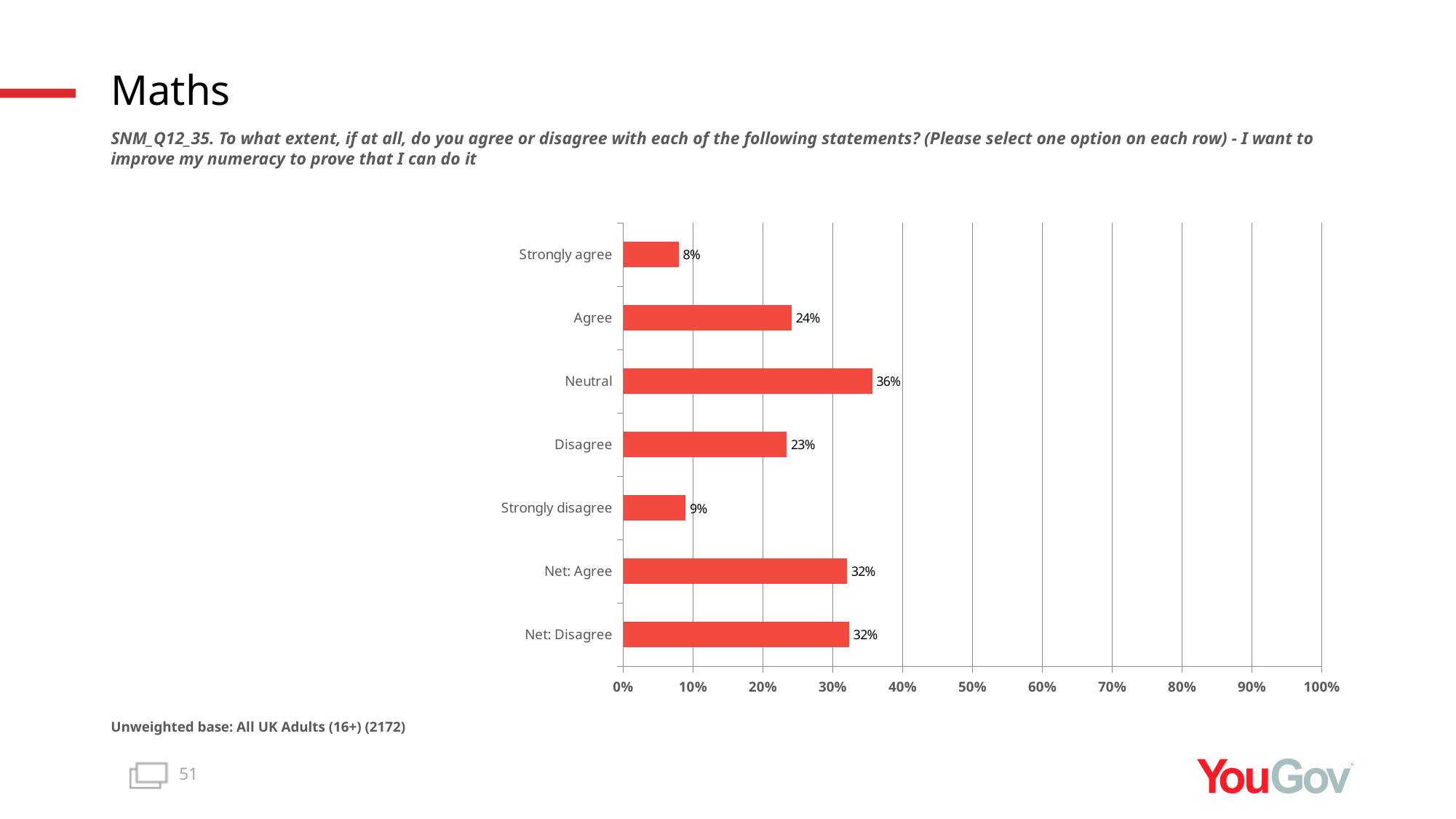
What is the difference between 'Agree' and 'Disagree'? 1% What is the difference between 'Neutral' and 'Strongly disagree'? 27% What is the unweighted base stated below the chart? All UK Adults (16+) (2172) Which is larger, 'Agree' or 'Strongly agree'? Agree How many categories are shown on the chart? 7 What percentage of respondents selected 'Neutral'? 36% What is the value for 'Net: Disagree'? 32% What is the value for 'Strongly agree'? 8% Is the value for 'Neutral' greater or less than 30%? greater Which category has the highest value? Neutral Which category has the lowest value? Strongly agree What kind of chart is shown on the slide? Bar chart